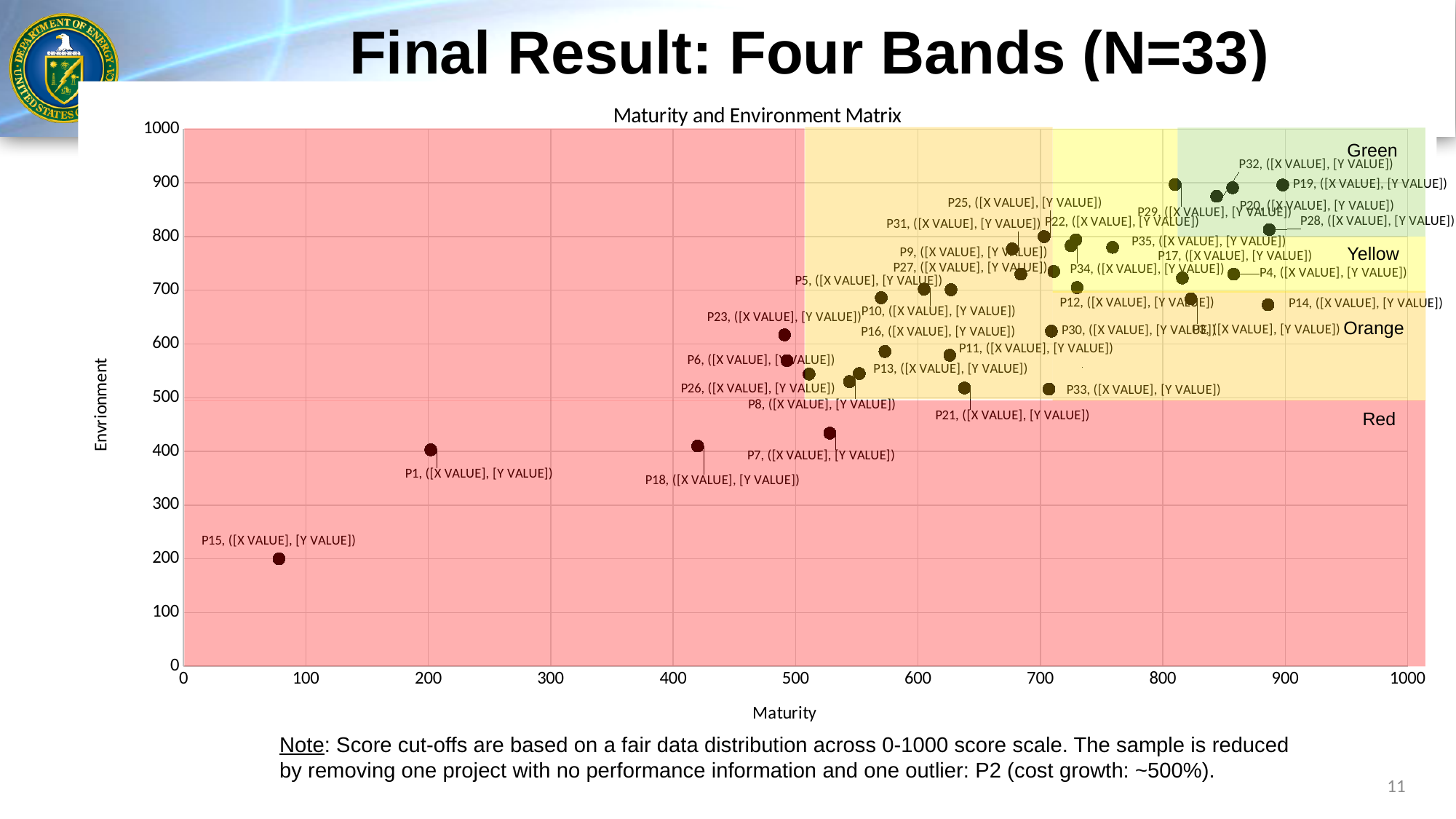
Is the Environment value for P19 greater or less than 800? greater Is the Environment value for P15 greater or less than 300? less Is the Maturity value for P1 greater or less than 300? less Which has the larger Maturity value, P18 or P7? P7 What kind of chart is shown on the slide? Scatter chart Which project has the lowest Environment value on the chart? P15 What is the title of the chart? Maturity and Environment Matrix What are the four bands labelled on the chart? Green, Yellow, Orange, Red Which has the larger Environment value, P1 or P15? P1 Which project has the lowest Maturity value on the chart? P15